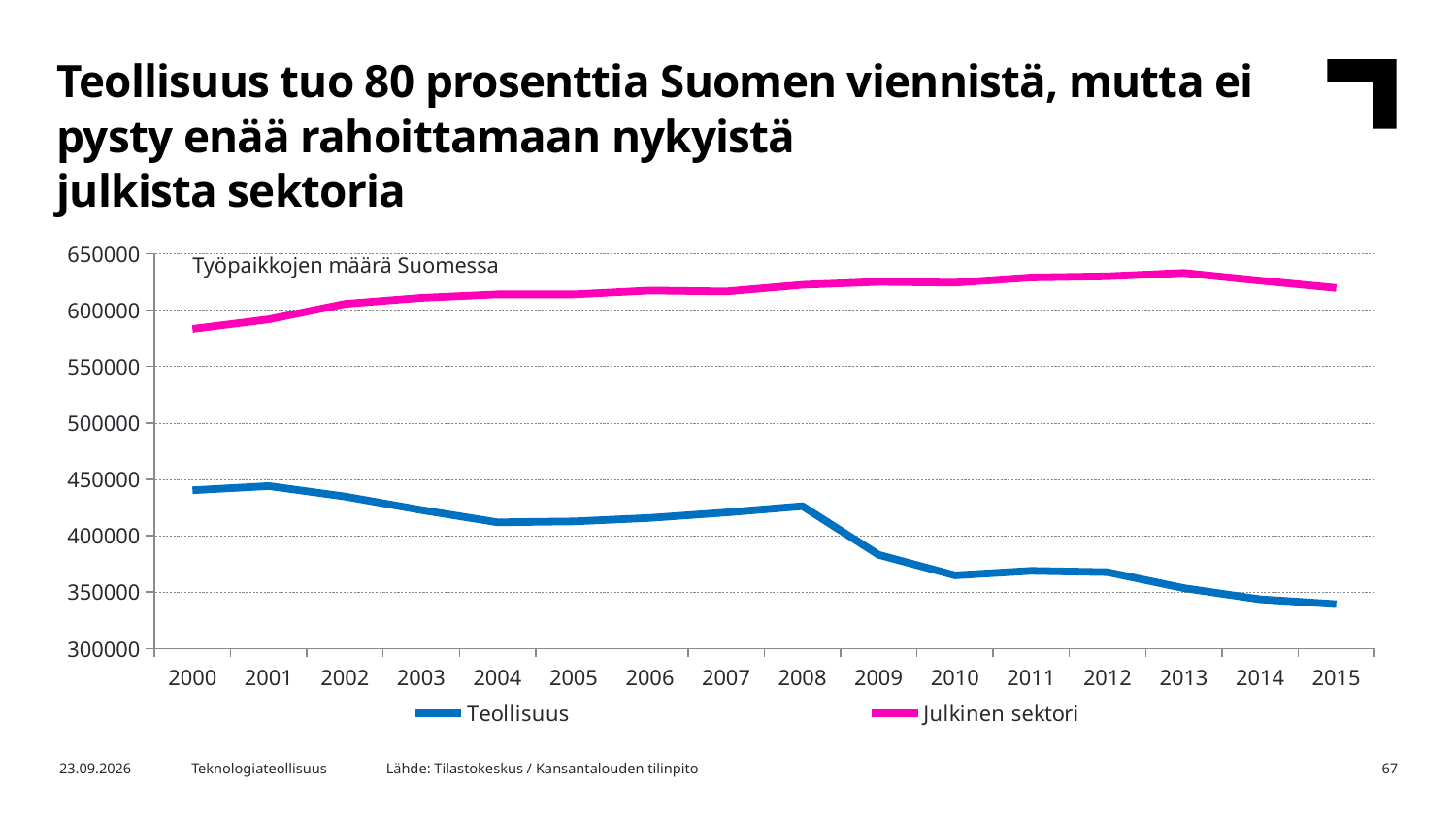
What kind of chart is shown on the slide? Line chart In which year is the Julkinen sektori value lowest? 2000 Does the Julkinen sektori line rise or fall overall from 2000 to 2015? Rise What is the title printed inside the chart area? Työpaikkojen määrä Suomessa Which series is drawn in pink? Julkinen sektori How many years are shown along the x axis of the chart? 16 Is the value for Teollisuus in 2015 greater or less than 350000? less Does the Teollisuus line rise or fall overall from 2000 to 2015? Fall Which series has the higher value in 2010, Teollisuus or Julkinen sektori? Julkinen sektori Is the value for Teollisuus in 2000 greater or less than 400000? greater Is the value for Julkinen sektori in 2000 greater or less than 600000? less How many series does the chart legend list? 2